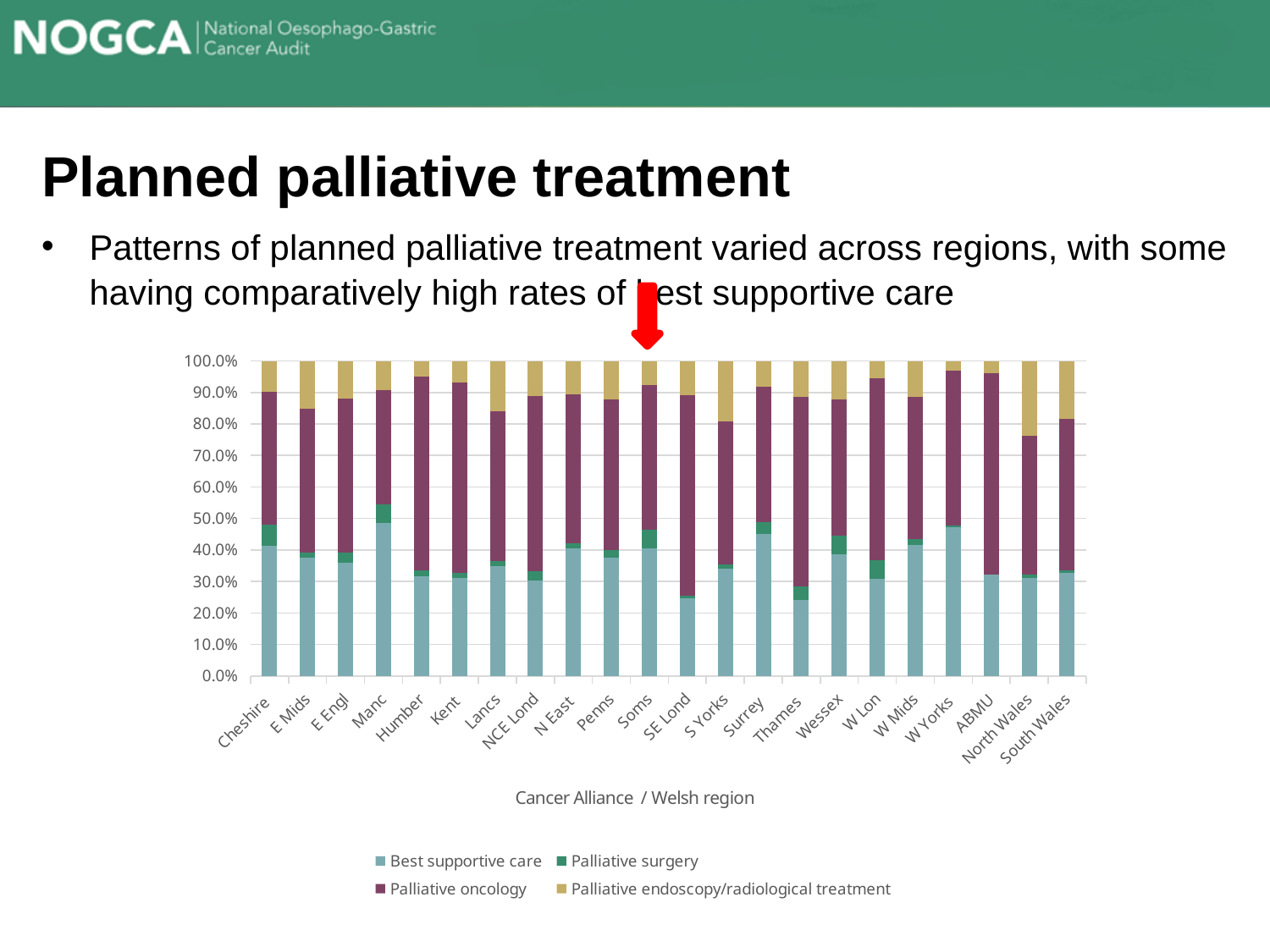
Which series is shown in yellow at the top of each bar? Palliative endoscopy/radiological treatment Is the Best supportive care value for Thames greater or less than 30.0%? less How many series does the chart legend list? 4 Which region has the largest Palliative endoscopy/radiological treatment segment? North Wales What is the x-axis title of the chart? Cancer Alliance / Welsh region Which has the larger Best supportive care value, Manc or SE Lond? Manc What total does each stacked bar reach on the y axis? 100.0% Is the Best supportive care value for SE Lond greater or less than 30.0%? less Which has the larger Best supportive care value, W Yorks or Thames? W Yorks Is the Best supportive care value for Manc greater or less than 40.0%? greater What kind of chart is shown on the slide? Stacked bar chart How many regions (categories) are plotted along the x axis? 22